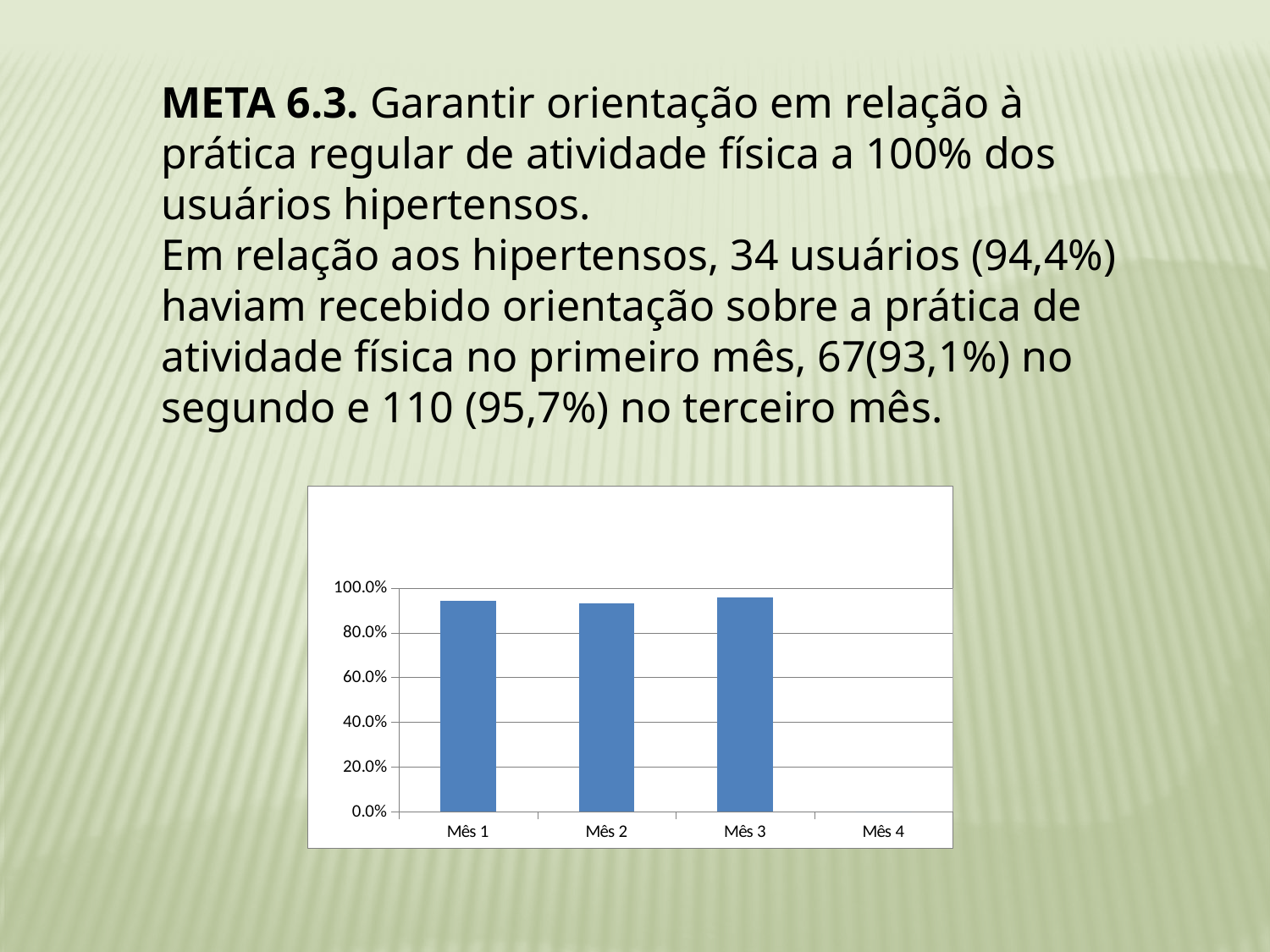
Is the value for Mês 2 greater or less than 80.0%? greater Is the value for Mês 2 greater or less than 100.0%? less What is the label of the first category on the x axis? Mês 1 Is the value for Mês 1 greater or less than 80.0%? greater What is the highest tick value shown on the y axis of the chart? 100.0% What kind of chart is shown on the slide? bar chart How many categories are labelled on the x axis of the chart? 4 How many bars are plotted in the chart? 3 Which category on the x axis has no bar plotted? Mês 4